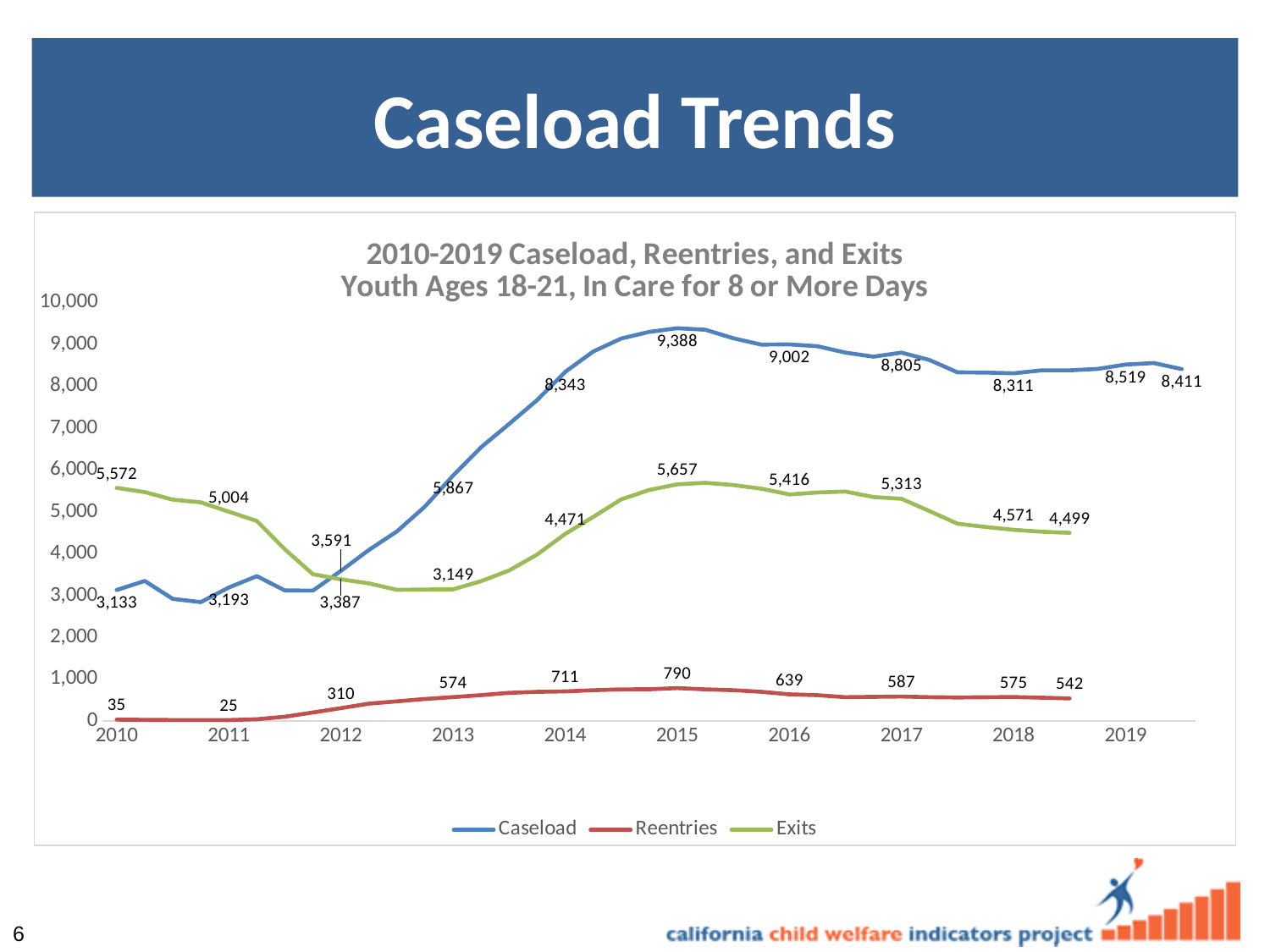
What is the lowest labelled value on the Reentries line? 25 How many series does the legend list? 3 What is the difference between the Exits values for 2010 and 2011? 568 What kind of chart is shown on the slide? line chart What is the difference between the Reentries values for 2015 and 2016? 151 What is the highest labelled value on the Caseload line? 9,388 What is the Reentries value for 2015? 790 Do the Reentries values rise or fall from 2010 to 2015? rise What is the Exits value for 2010? 5,572 In 2010, which is larger, Caseload or Exits? Exits Is the Caseload value for 2016 greater or less than 8,000? greater What is the highest labelled value on the Exits line? 5,657